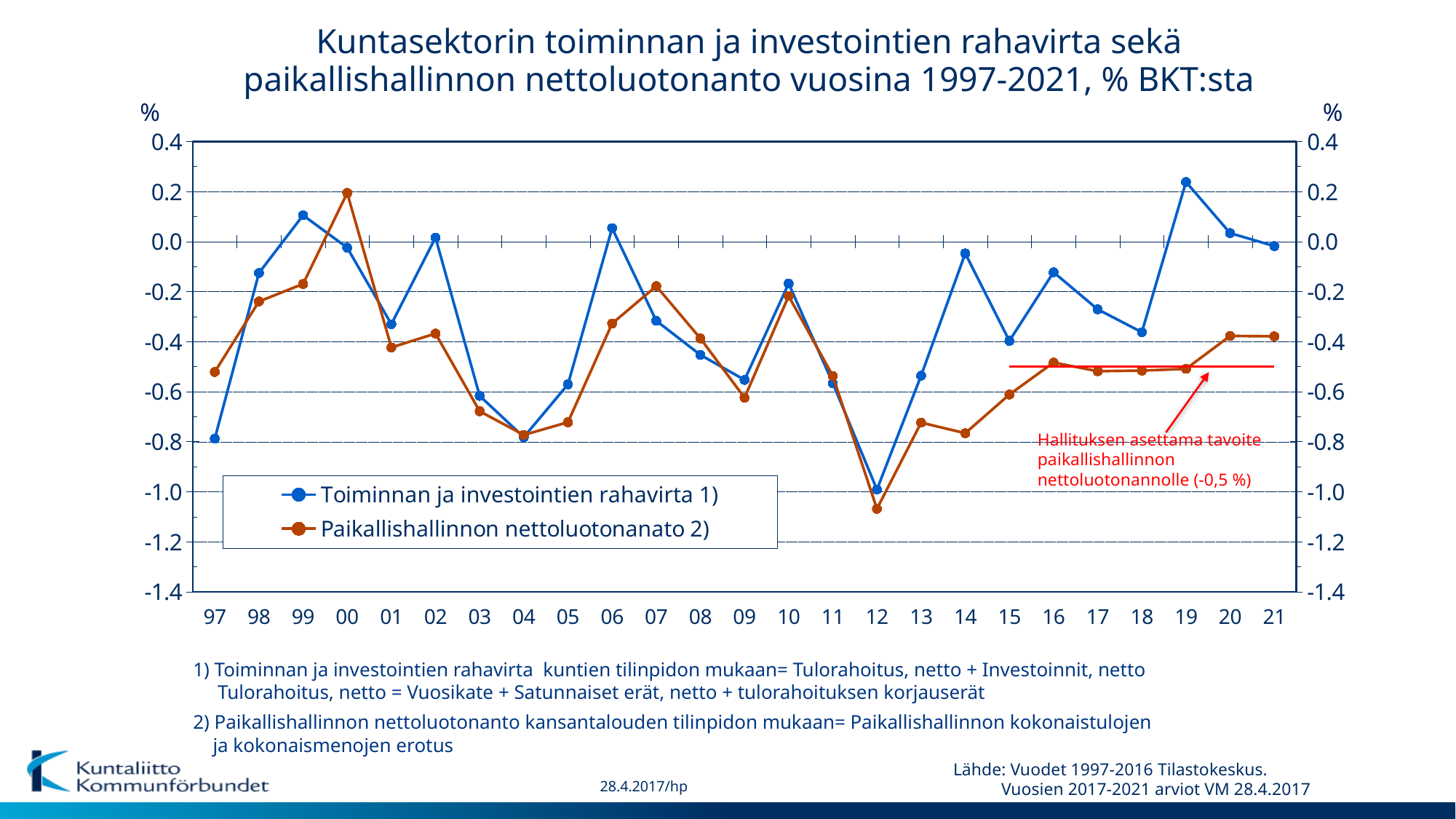
In which year does the series 'Paikallishallinnon nettoluotonanato 2)' reach its lowest value? 12 Is the value for 'Paikallishallinnon nettoluotonanato 2)' in 12 greater or less than -1.0? less In which year does the series 'Toiminnan ja investointien rahavirta 1)' reach its highest value? 19 How many years are plotted along the x axis? 25 Is the value for 'Toiminnan ja investointien rahavirta 1)' in 97 greater or less than -0.6? less Is the value for 'Toiminnan ja investointien rahavirta 1)' in 19 greater or less than 0.0? greater In 00, which series has the higher value: 'Toiminnan ja investointien rahavirta 1)' or 'Paikallishallinnon nettoluotonanato 2)'? Paikallishallinnon nettoluotonanato 2) What kind of chart is shown on the slide? line chart How many series does the legend list? 2 In which year does the series 'Paikallishallinnon nettoluotonanato 2)' reach its highest value? 00 What target value for paikallishallinnon nettoluotonanto does the red horizontal line mark? -0,5 % Does the series 'Paikallishallinnon nettoluotonanato 2)' rise or fall from 12 to 16? rise